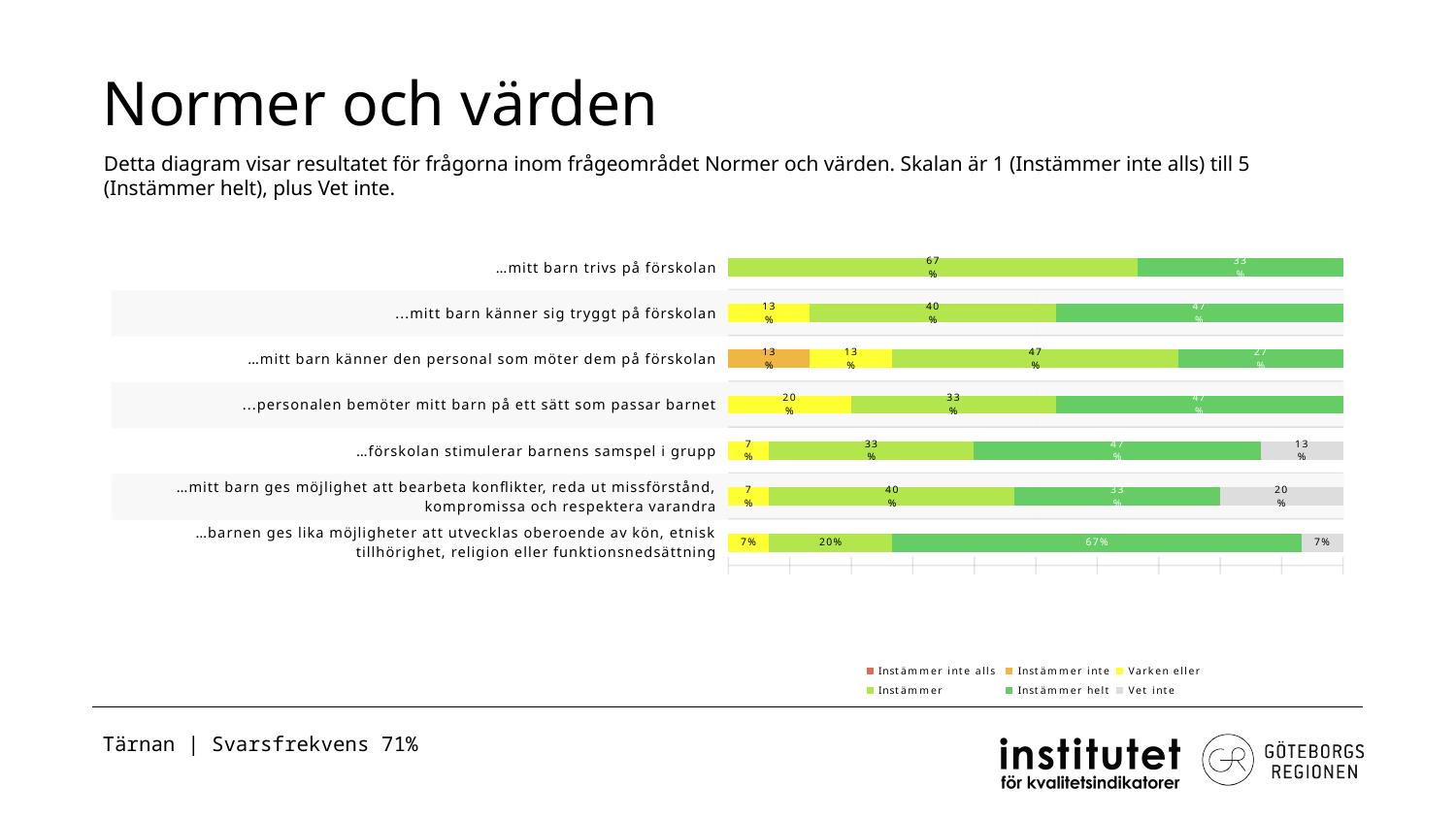
What is the "Instämmer" value for "…mitt barn trivs på förskolan"? 67% How many series does the legend list? 6 How many statements (categories) are plotted in the chart? 7 What is the "Varken eller" value for "…förskolan stimulerar barnens samspel i grupp"? 7% What is the difference between the "Instämmer" value and the "Instämmer helt" value for "…mitt barn trivs på förskolan"? 34 percentage points Which statement has the highest "Instämmer helt" value? …barnen ges lika möjligheter att utvecklas oberoende av kön, etnisk tillhörighet, religion eller funktionsnedsättning What is the "Instämmer helt" value for "…mitt barn känner sig tryggt på förskolan"? 47% What is the "Instämmer inte" value for "…mitt barn känner den personal som möter dem på förskolan"? 13% Which is larger for "…personalen bemöter mitt barn på ett sätt som passar barnet": the "Varken eller" value or the "Instämmer" value? Instämmer Which legend entry is shown in grey? Vet inte What is the "Vet inte" value for "…mitt barn ges möjlighet att bearbeta konflikter, reda ut missförstånd, kompromissa och respektera varandra"? 20% What kind of chart is shown on the slide? Stacked bar chart